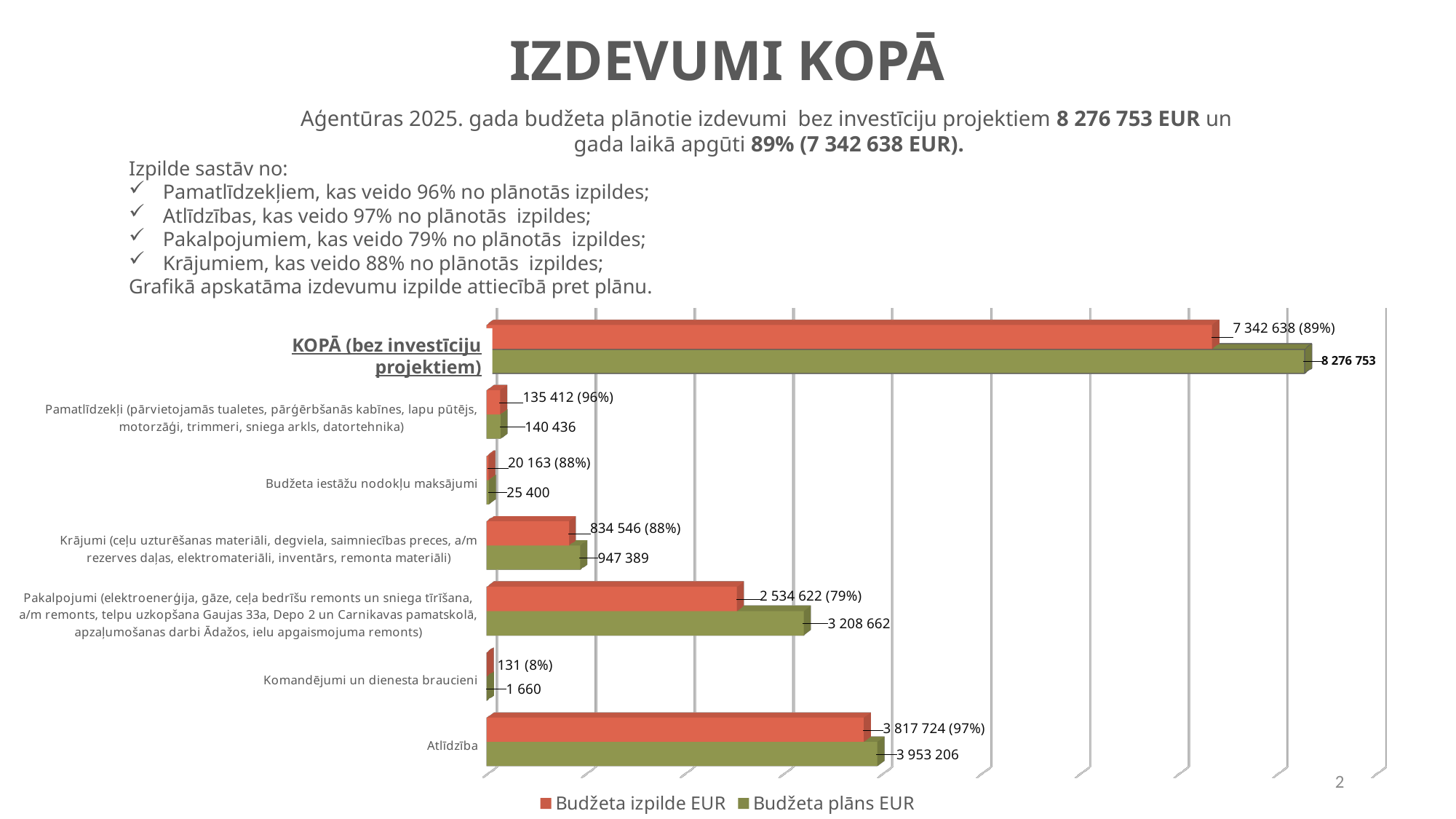
How many series does the chart legend list? 2 Which category has the highest Budžeta izpilde EUR value? KOPĀ (bez investīciju projektiem) Which colour represents the Budžeta plāns EUR series in the chart? Green How many categories are shown on the chart's vertical axis? 7 Which category has the lowest Budžeta plāns EUR value? Komandējumi un dienesta braucieni What is the Budžeta plāns EUR value for Pakalpojumi? 3 208 662 What type of chart is shown on the slide? Bar chart What is the Budžeta izpilde EUR value for Komandējumi un dienesta braucieni? 131 (8%) What is the Budžeta plāns EUR value for Krājumi? 947 389 What is the difference between the Budžeta plāns EUR and Budžeta izpilde EUR values for Pakalpojumi? 674 040 Which is larger for Atlīdzība: the Budžeta izpilde EUR value or the Budžeta plāns EUR value? Budžeta plāns EUR What is the Budžeta izpilde EUR value for Atlīdzība? 3 817 724 (97%)